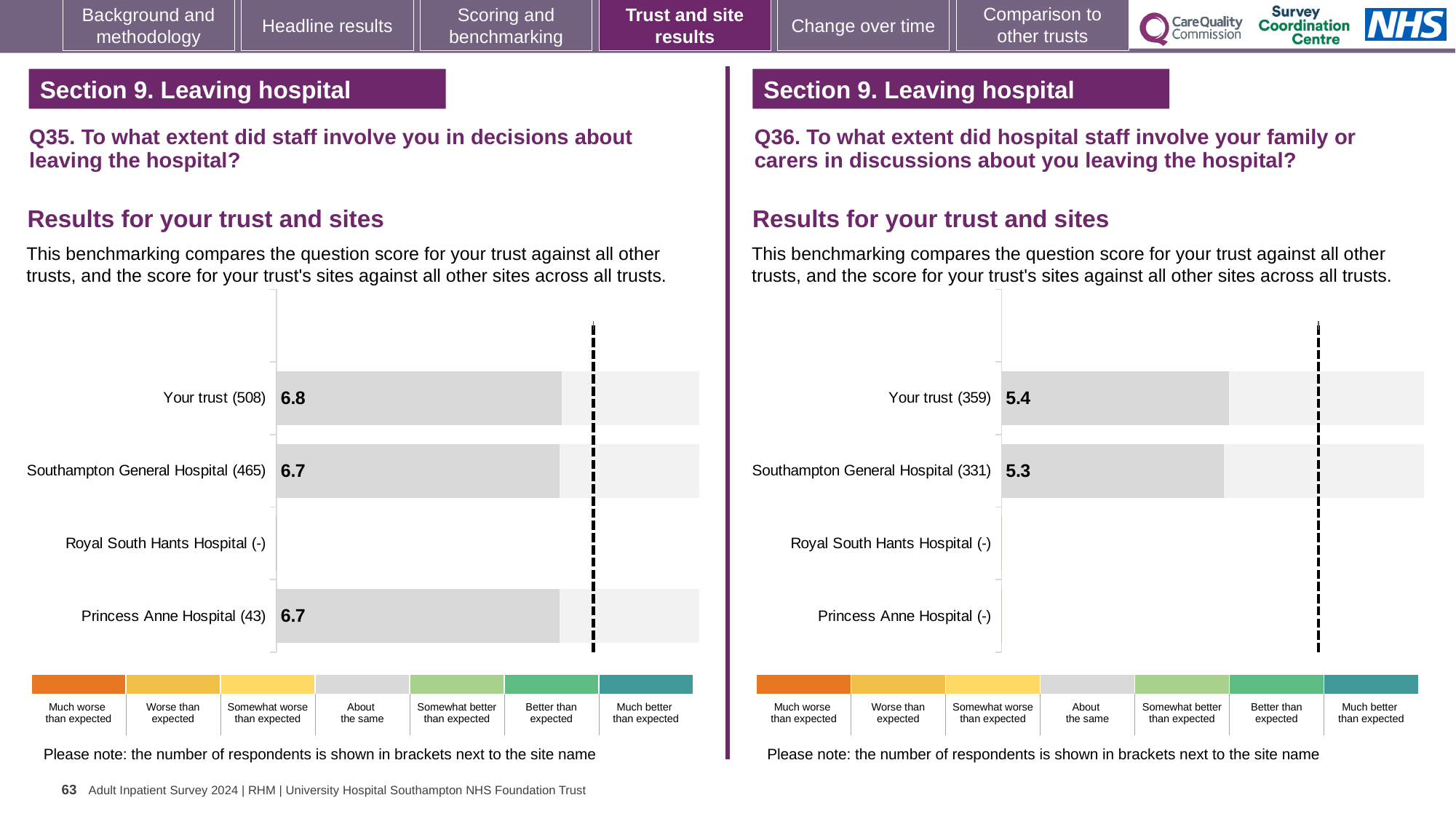
On the Q35 chart (left), which row has the highest score? Your trust On the Q36 chart (right), how many respondents are shown in brackets for Southampton General Hospital? 331 What kind of chart is used on the Q35 chart (left)? Bar chart On the Q35 chart (left), what is the score for Southampton General Hospital? 6.7 On the Q36 chart (right), what is the score for Southampton General Hospital? 5.3 On the Q35 chart (left), what is the score for Princess Anne Hospital? 6.7 On the Q35 chart (left), what is the difference between the scores for Your trust and Southampton General Hospital? 0.1 On the Q35 chart (left), how many respondents are shown in brackets for Your trust? 508 On the Q35 chart (left), what is the score for Your trust? 6.8 On the Q36 chart (right), what is the score for Your trust? 5.4 On the Q36 chart (right), what is the difference between the scores for Your trust and Southampton General Hospital? 0.1 On the Q36 chart (right), which is larger, the score for Your trust or for Southampton General Hospital? Your trust